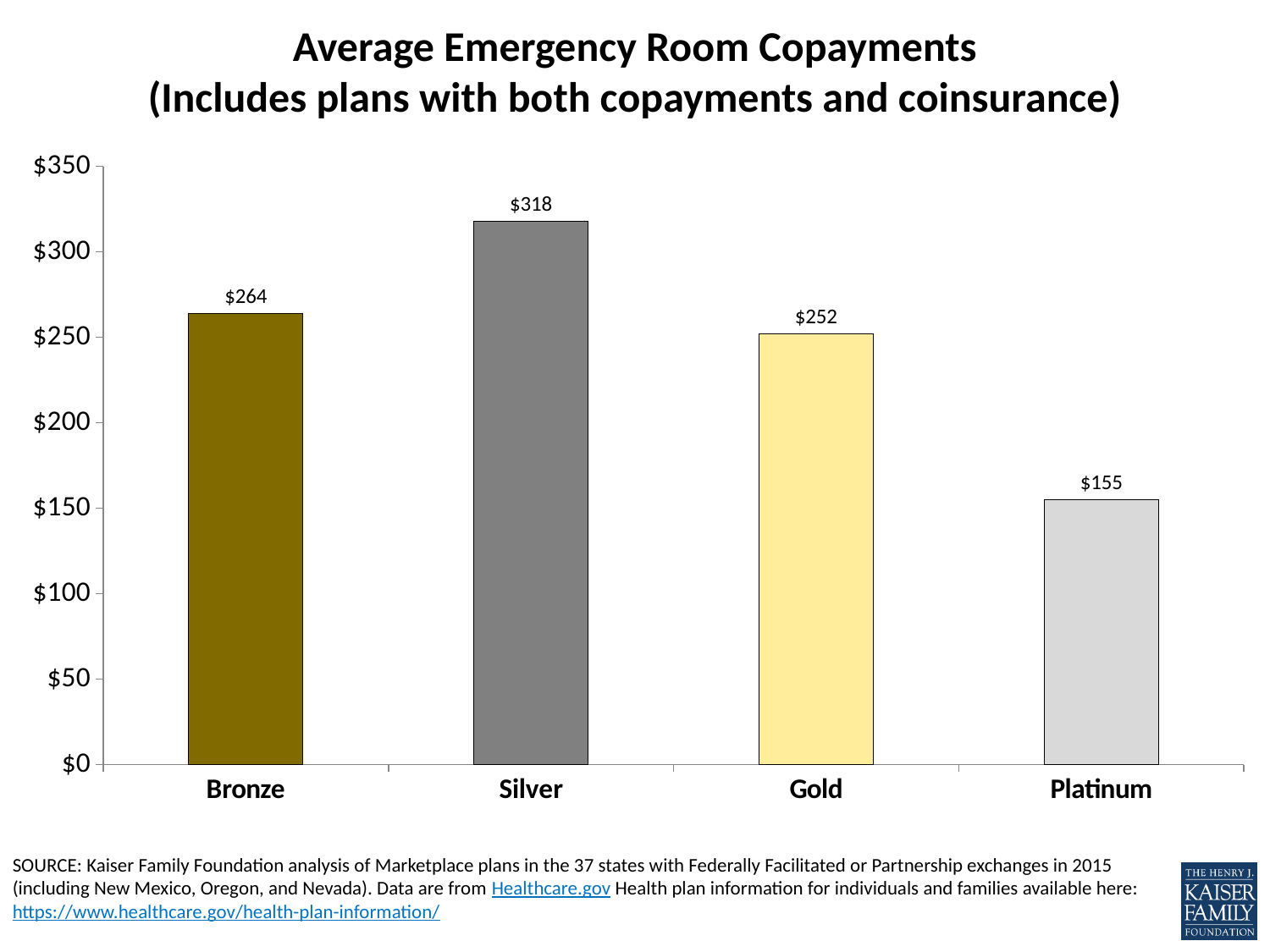
What is the title of the chart? Average Emergency Room Copayments (Includes plans with both copayments and coinsurance) What is the average emergency room copayment for Bronze plans? $264 What is the difference between the Silver and Platinum average emergency room copayments? $163 Which plan type has the highest average emergency room copayment? Silver What kind of chart is shown on the slide? Bar chart What is the average emergency room copayment for Platinum plans? $155 How many plan types are shown on the chart? 4 Which plan type has the lowest average emergency room copayment? Platinum Which has a higher average emergency room copayment, Bronze or Gold? Bronze What is the average emergency room copayment for Silver plans? $318 Is the value for Gold greater or less than $300? less What is the difference between the Bronze and Gold average emergency room copayments? $12